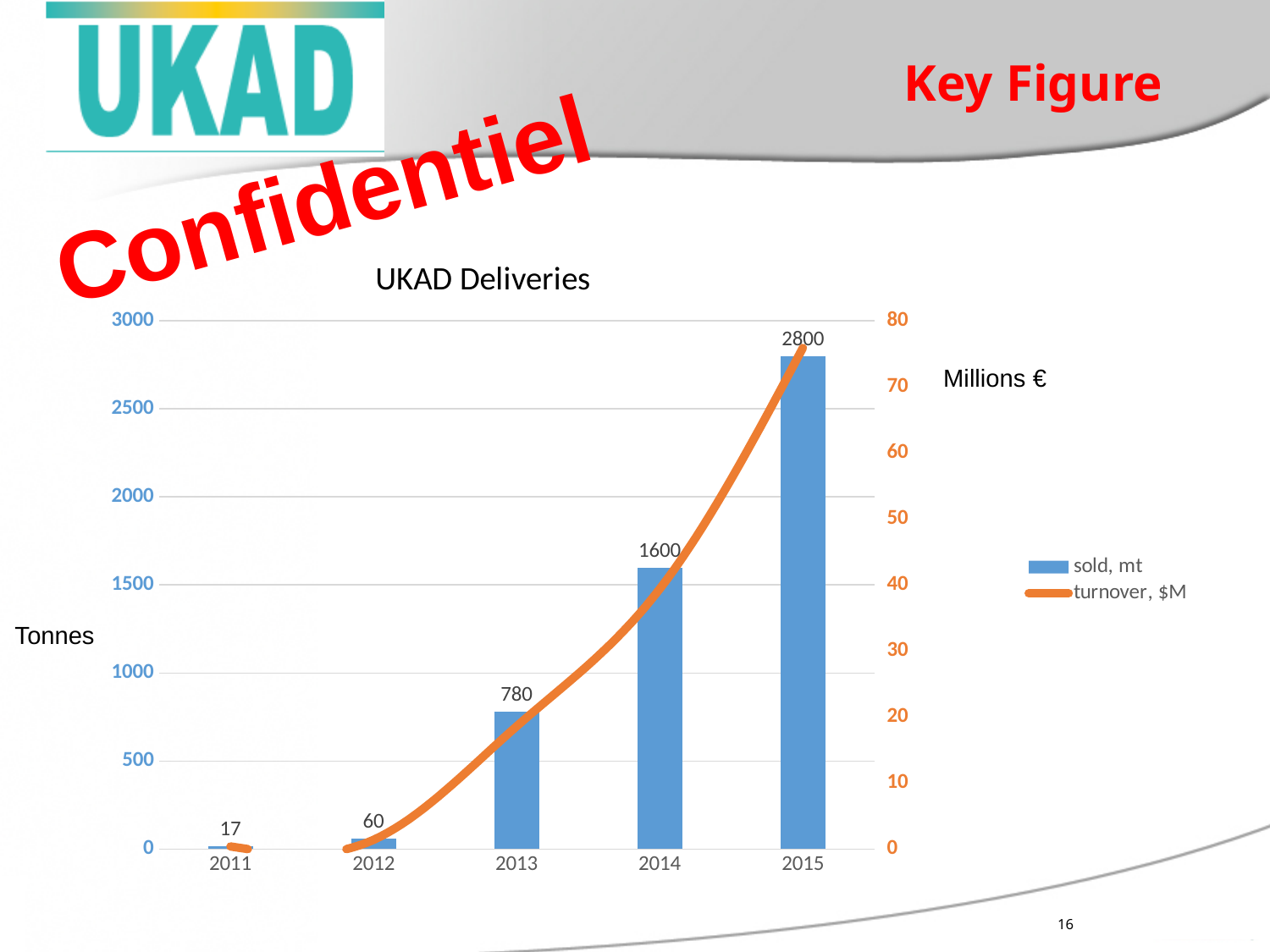
What is the value of sold, mt for 2013 in the UKAD Deliveries chart? 780 Is the turnover, $M value for 2015 greater or less than 70 in the UKAD Deliveries chart? greater Which year has the lowest sold, mt value in the UKAD Deliveries chart? 2011 What is the value of sold, mt for 2015 in the UKAD Deliveries chart? 2800 What is the difference in sold, mt between 2015 and 2014 in the UKAD Deliveries chart? 1200 What is the value of sold, mt for 2011 in the UKAD Deliveries chart? 17 Which year has the highest sold, mt value in the UKAD Deliveries chart? 2015 How many years are shown on the x axis of the UKAD Deliveries chart? 5 Is the turnover, $M value for 2014 greater or less than 30 in the UKAD Deliveries chart? greater How many series does the legend of the UKAD Deliveries chart list? 2 Which year has a larger sold, mt value in the UKAD Deliveries chart, 2012 or 2013? 2013 Do the sold, mt values rise or fall from 2011 to 2015 in the UKAD Deliveries chart? rise